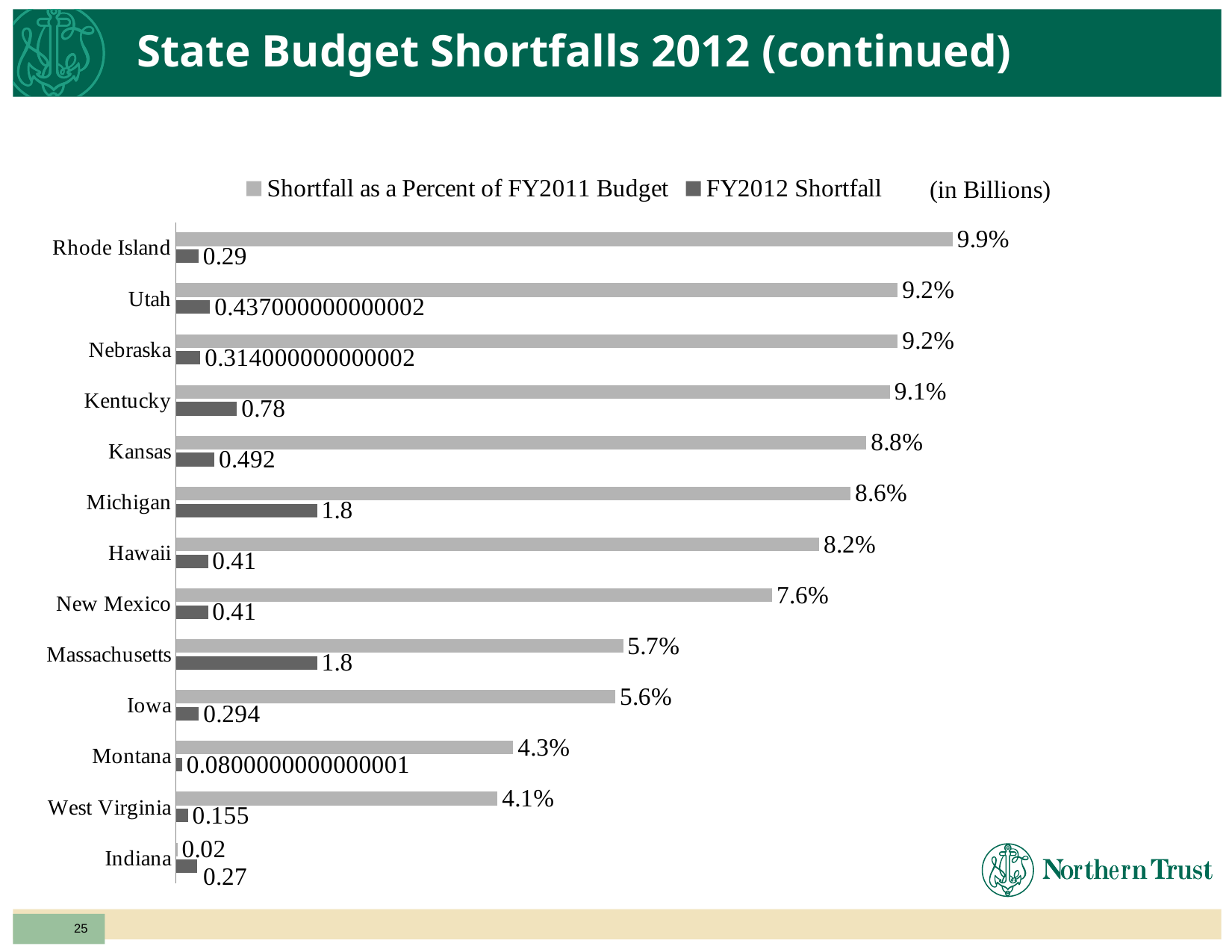
Which state has the lowest FY2012 shortfall? Montana What unit is given in parentheses next to the legend? in Billions How many states are shown on the chart? 13 What is the difference between Rhode Island's and Utah's shortfall as a percent of FY2011 budget? 0.7 percentage points What kind of chart is shown on the slide? Bar chart Do the shortfall-as-a-percent values rise or fall going from Rhode Island down to West Virginia? Fall What is the FY2012 shortfall for Iowa? 0.294 What is the shortfall as a percent of FY2011 budget for Rhode Island? 9.9% How many series does the legend list? 2 What is the FY2012 shortfall for Kentucky? 0.78 Which has the larger FY2012 shortfall, Michigan or Kansas? Michigan Which state has the highest shortfall as a percent of FY2011 budget? Rhode Island